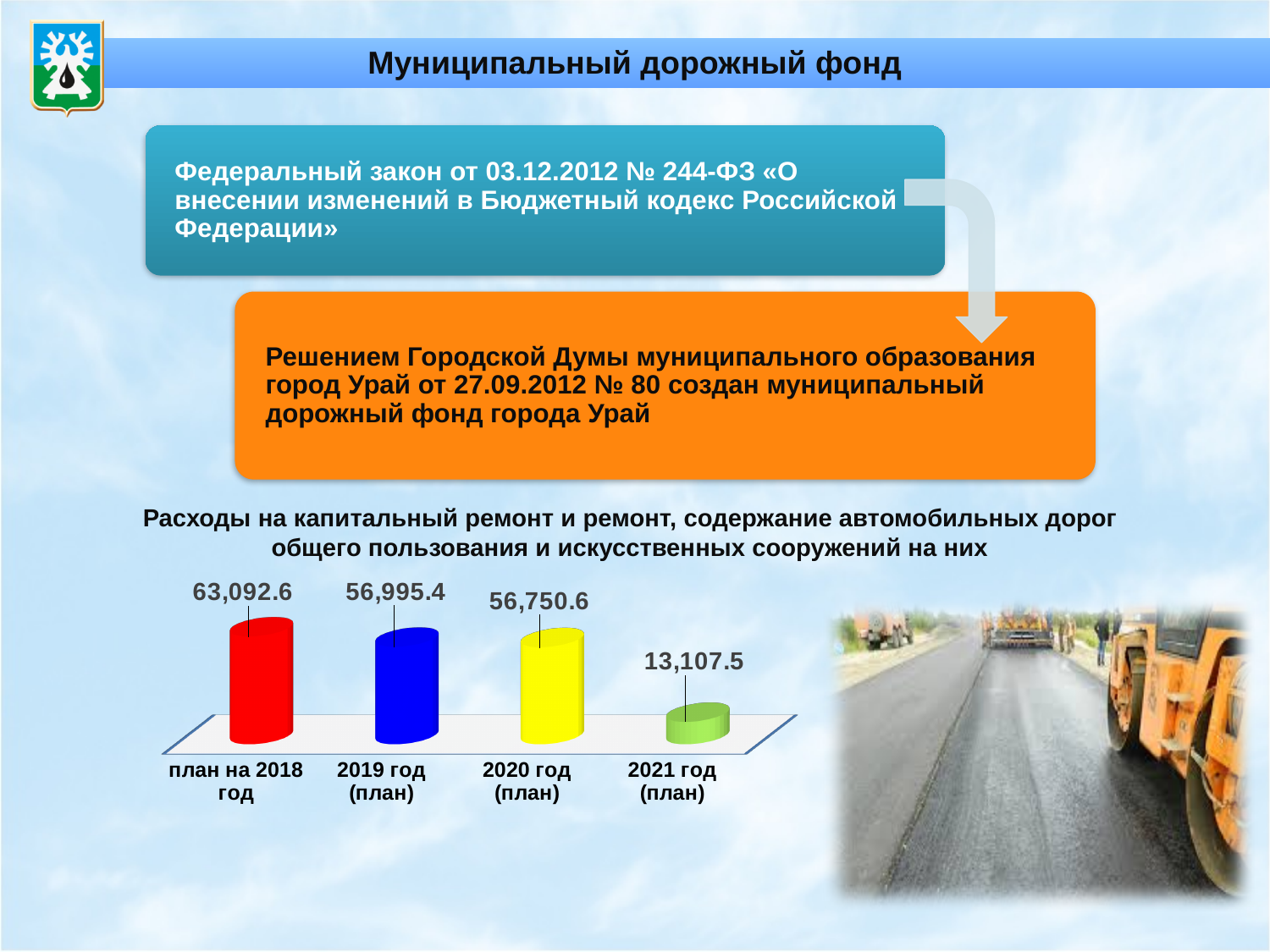
Which category has the highest value? план на 2018 год What is the value for «план на 2018 год»? 63,092.6 Which is larger: the value for «план на 2018 год» or for «2019 год (план)»? план на 2018 год Which category has the lowest value? 2021 год (план) What kind of chart is shown on the slide? bar chart What is the value for «2020 год (план)»? 56,750.6 What is the value for «2021 год (план)»? 13,107.5 What is the value for «2019 год (план)»? 56,995.4 What is the difference between the values for «план на 2018 год» and «2019 год (план)»? 6,097.2 What is the difference between the values for «2020 год (план)» and «2021 год (план)»? 43,643.1 How many categories are shown in the chart? 4 Do the values rise or fall from «план на 2018 год» to «2021 год (план)»? fall